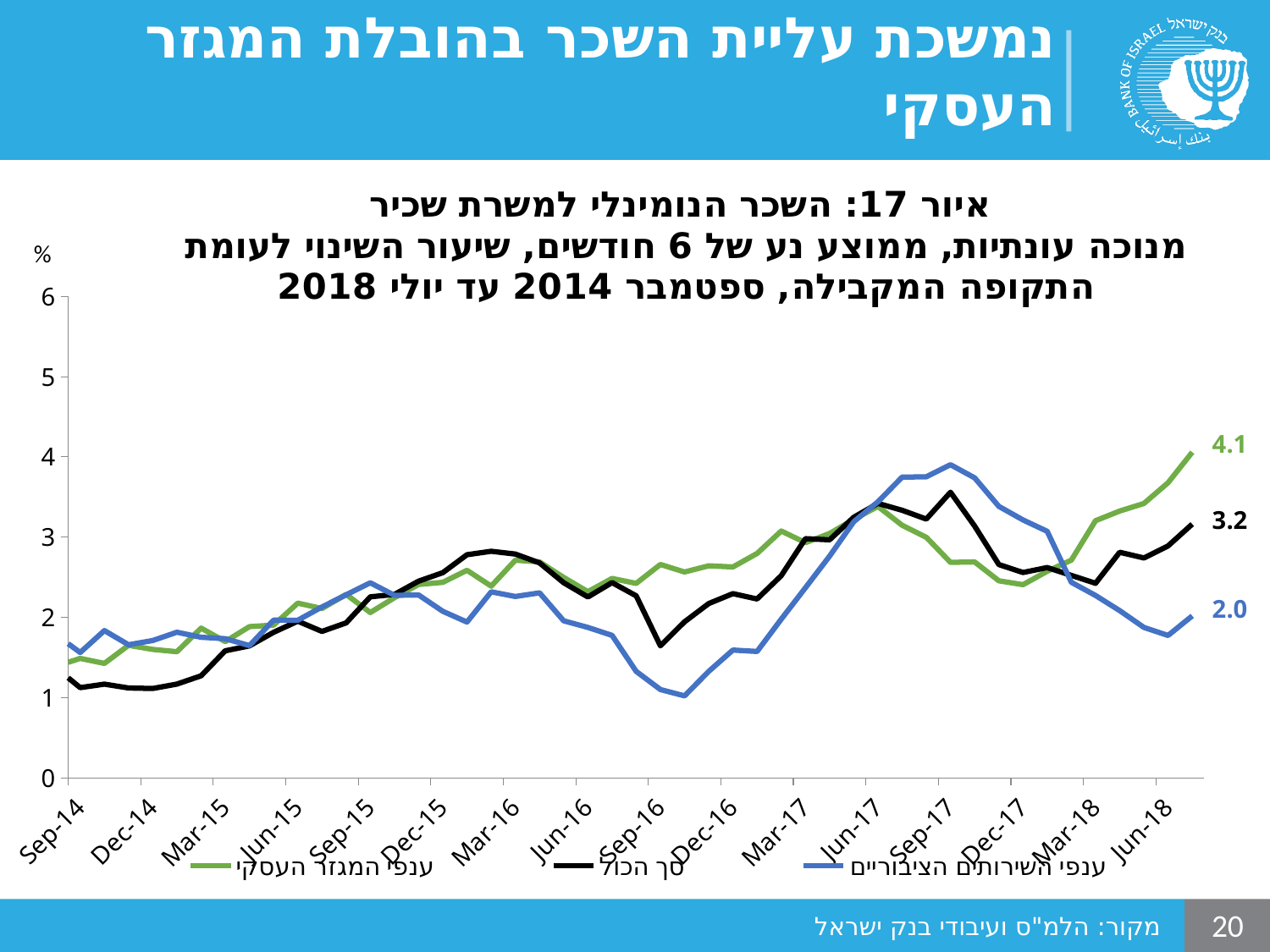
Does the ענפי השירותים הציבוריים (blue) line rise or fall between Sep-17 and Jun-18? Fall What is the difference between the final labelled values of ענפי המגזר העסקי and ענפי השירותים הציבוריים? 2.1 Is the value of the ענפי השירותים הציבוריים (blue) line at Sep-16 greater or less than 2? less What is the final labelled value of the ענפי השירותים הציבוריים (blue) line? 2.0 What is the final labelled value of the סך הכול (black) line? 3.2 Is the value of the ענפי המגזר העסקי (green) line at Jun-17 greater or less than 3? greater Which series has the highest labelled value at the end of the chart? ענפי המגזר העסקי Which series has the lowest labelled value at the end of the chart? ענפי השירותים הציבוריים At the end of the chart, which is larger: the value for סך הכול or the value for ענפי השירותים הציבוריים? סך הכול How many series does the legend list? 3 What kind of chart is shown on the slide? Line chart What is the final labelled value of the ענפי המגזר העסקי (green) line? 4.1